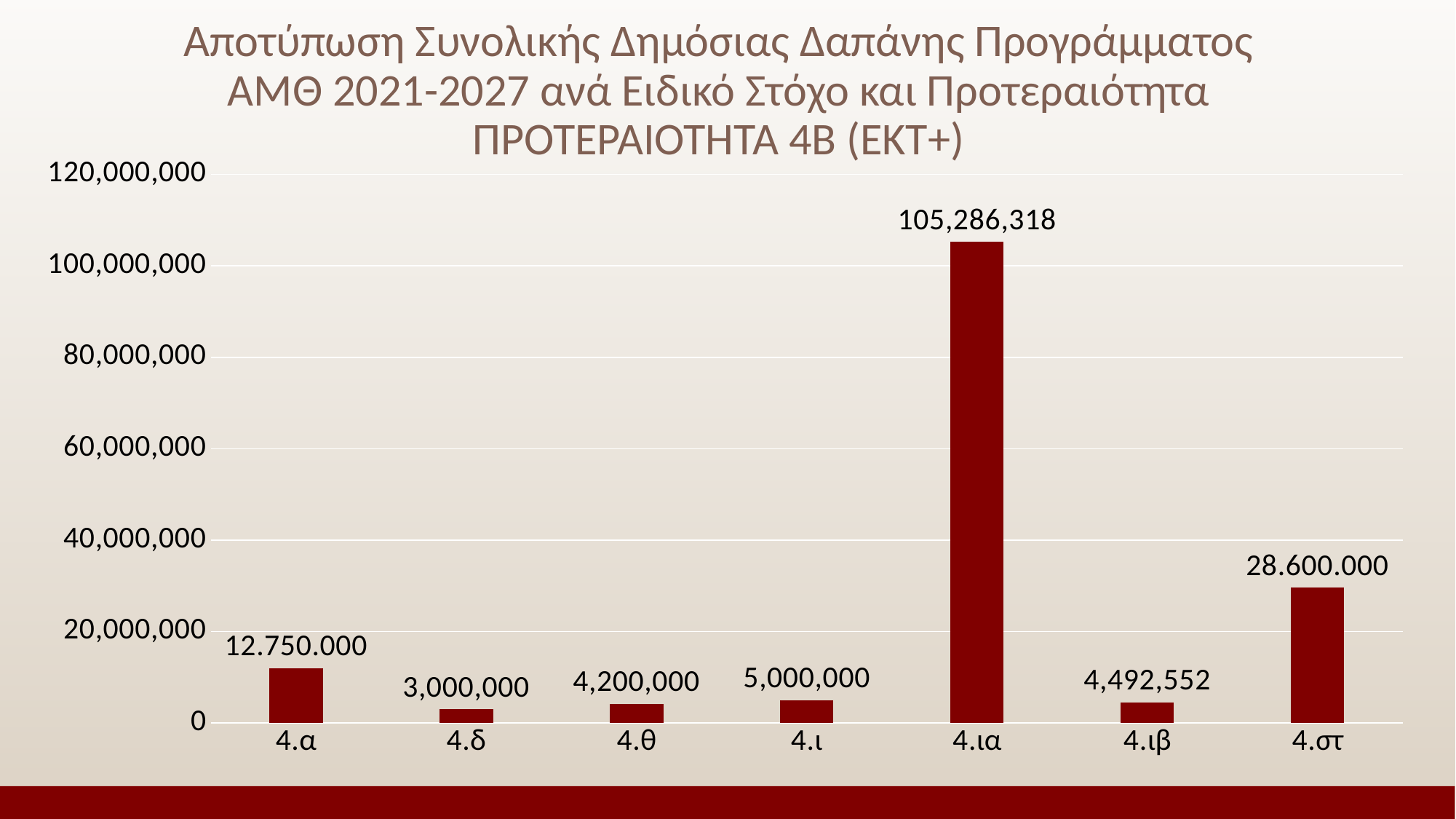
Is the value for 4.ια greater or less than 100,000,000? greater Which category has the highest value? 4.ια What is the difference between the values for 4.ι and 4.δ? 2,000,000 What is the value for 4.ια? 105,286,318 Which category has the lowest value? 4.δ What kind of chart is shown on the slide? bar chart What is the value for 4.ιβ? 4,492,552 How many categories are shown on the x axis? 7 What is the value for 4.στ? 28.600.000 Which is larger, the value for 4.στ or the value for 4.α? 4.στ What is the difference between the values for 4.ιβ and 4.θ? 292,552 What is the value for 4.α? 12.750.000